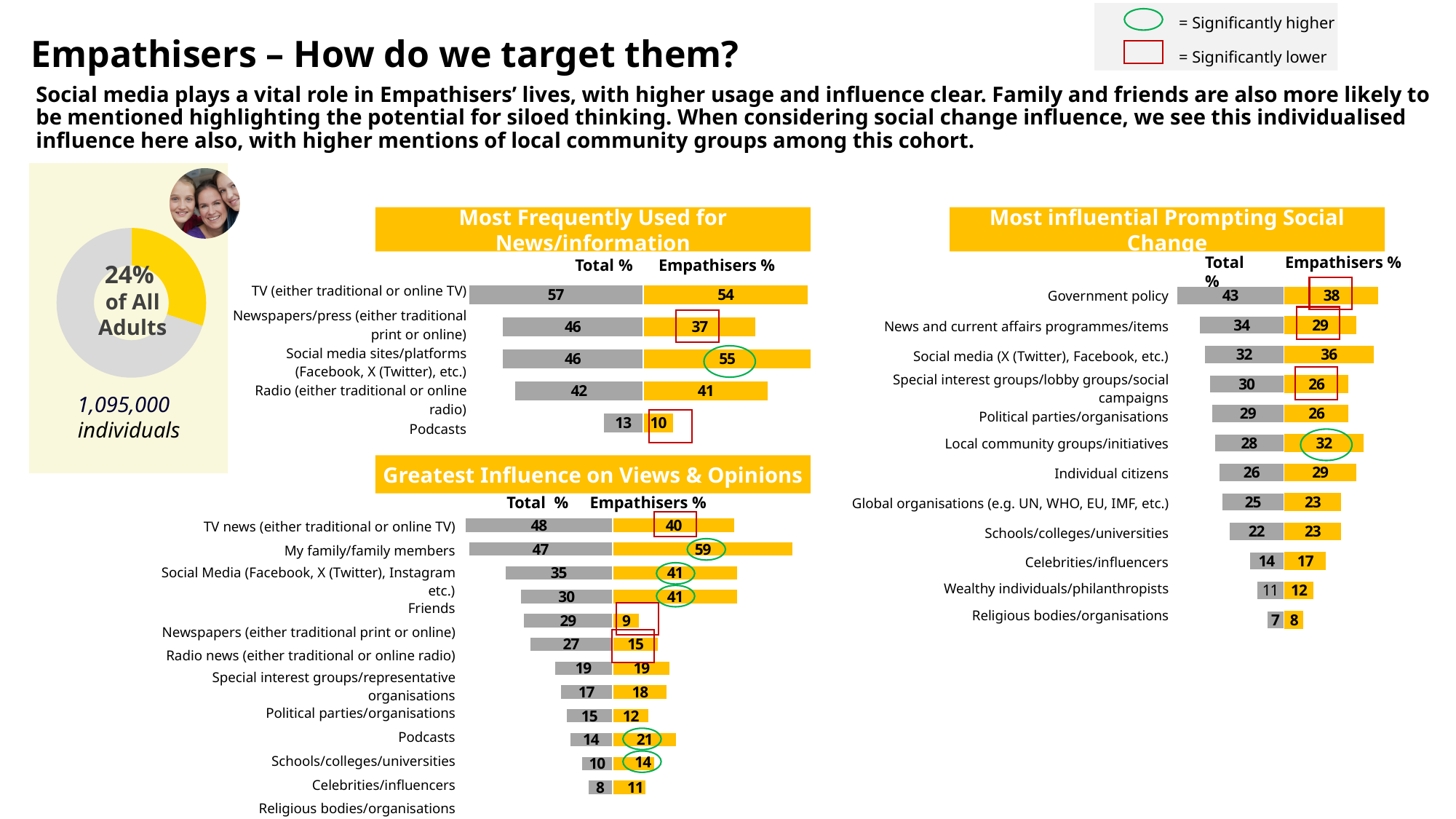
In the 'Most Frequently Used for News/information' chart, what is the Total % for Podcasts? 13 In the 'Most influential Prompting Social Change' chart, what is the Empathisers % for Local community groups/initiatives? 32 In the 'Greatest Influence on Views & Opinions' chart, what is the difference between the Total % and Empathisers % for TV news? 8 In the 'Greatest Influence on Views & Opinions' chart, what is the Empathisers % for My family/family members? 59 What type of chart is 'Most Frequently Used for News/information'? Bar chart In the 'Most Frequently Used for News/information' chart, what is the Empathisers % for Social media sites/platforms? 55 How many categories are shown in the 'Most influential Prompting Social Change' chart? 12 In the 'Most Frequently Used for News/information' chart, what is the difference between the Total % and Empathisers % for Newspapers/press? 9 What share of all adults does the donut chart show for Empathisers? 24% In the 'Most influential Prompting Social Change' chart, is the Total % or the Empathisers % larger for Social media (X (Twitter), Facebook, etc.)? Empathisers % In the 'Most influential Prompting Social Change' chart, which category has the lowest Total %? Religious bodies/organisations In the 'Most Frequently Used for News/information' chart, which category has the highest Total %? TV (either traditional or online TV)